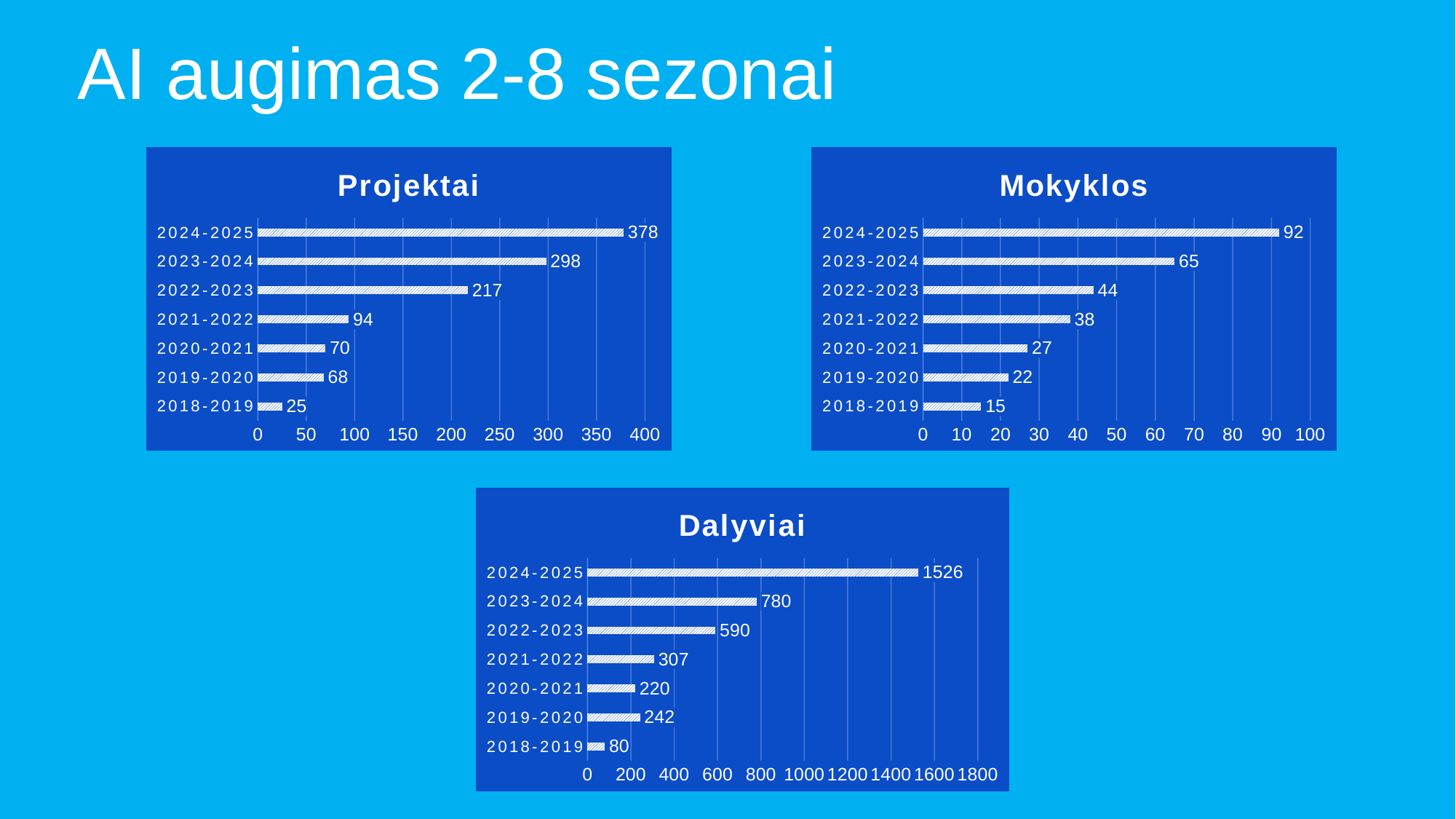
In the Dalyviai chart, what is the value for 2019-2020? 242 In the Projektai chart, which season has the highest value? 2024-2025 In the Mokyklos chart, which season has the lowest value? 2018-2019 In the Projektai chart, what is the value for 2022-2023? 217 In the Dalyviai chart, which is larger, the value for 2020-2021 or the value for 2019-2020? 2019-2020 In the Mokyklos chart, is the value for 2023-2024 greater or less than 60? greater In the Projektai chart, what is the difference between the values for 2023-2024 and 2022-2023? 81 How many seasons are shown in the Dalyviai chart? 7 In the Dalyviai chart, what is the difference between the values for 2024-2025 and 2023-2024? 746 What kind of chart is the Mokyklos chart? bar chart In the Mokyklos chart, what is the value for 2020-2021? 27 How many charts are on the slide? 3